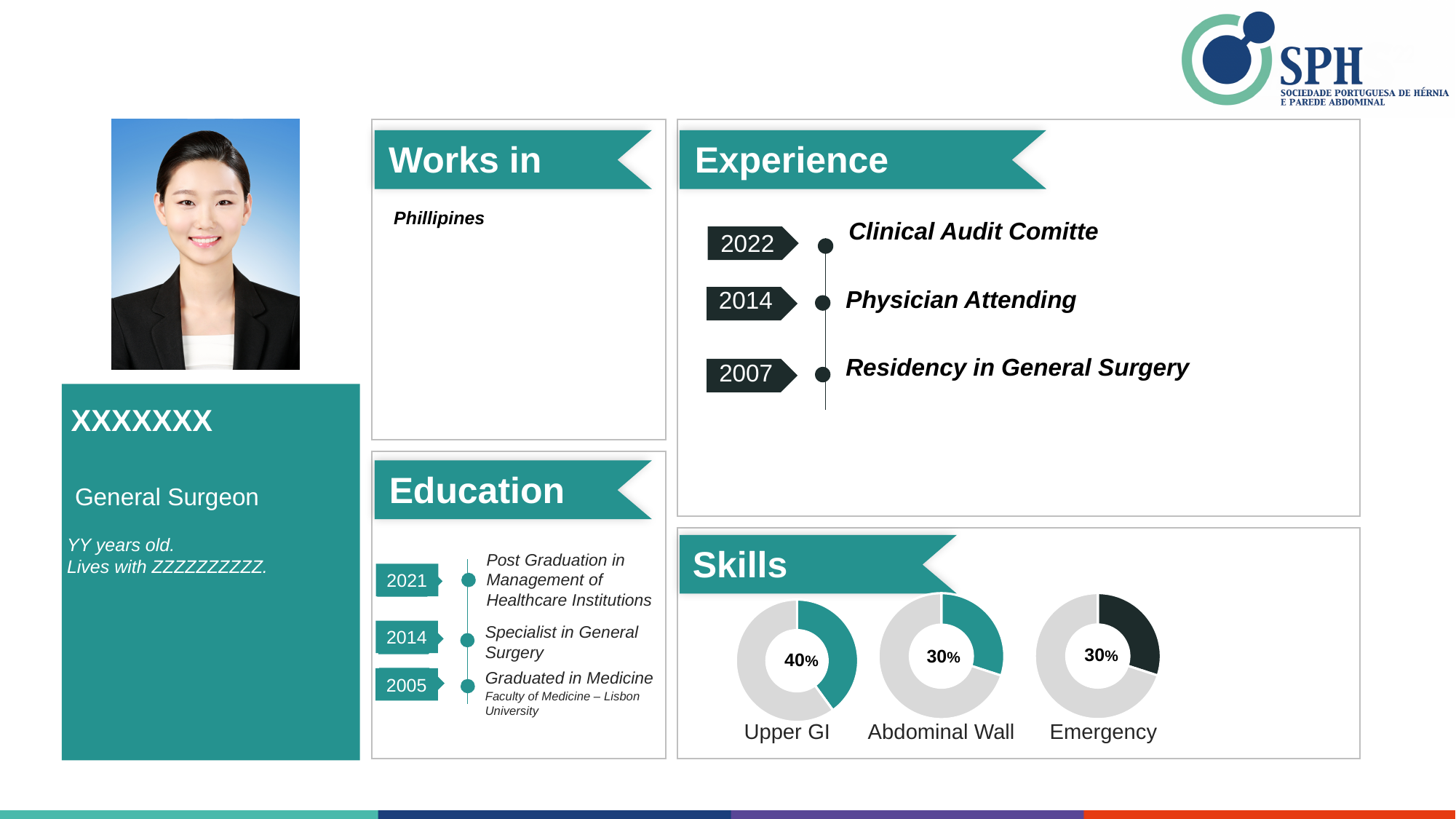
What is the label of the rightmost donut chart in the Skills section? Emergency In the Skills section, which is larger: the Upper GI value or the Abdominal Wall value? Upper GI In the Skills section, what is the difference between the Upper GI value and the Emergency value? 10% In the Skills section, is the Upper GI value greater or less than 50%? less In the Skills section, what value is shown in the Upper GI donut chart? 40% What kind of chart is used to show each skill in the Skills section? Donut chart In the Skills section, what value is shown in the Emergency donut chart? 30% How many donut charts are shown in the Skills section? 3 In the Skills section, what share of the Upper GI donut is filled? 40% In the Skills section, which skill's donut chart uses a dark segment instead of a teal one? Emergency In the Skills section, what value is shown in the Abdominal Wall donut chart? 30% Among the three Skills donut charts, which skill has the highest value? Upper GI